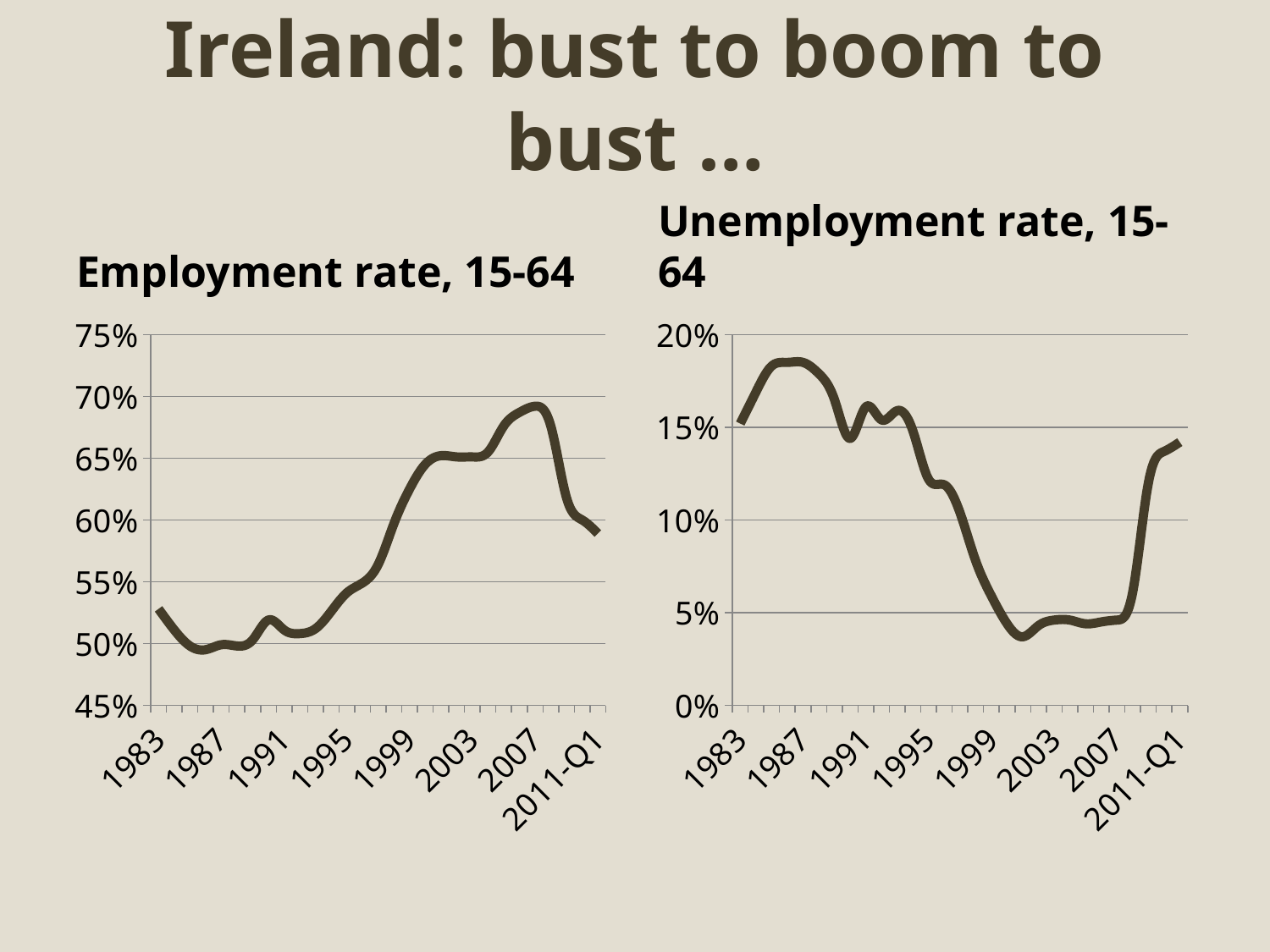
In the 'Employment rate, 15-64' chart, does the employment rate rise or fall between 1991 and 2007? rise In the 'Unemployment rate, 15-64' chart, is the value for 1987 greater or less than 15%? greater What kind of chart is the 'Unemployment rate, 15-64' chart? line chart How many charts are shown on the slide? 2 In the 'Employment rate, 15-64' chart, is the value for 2007 greater or less than 65%? greater In the 'Unemployment rate, 15-64' chart, is the value for 2011-Q1 greater or less than 10%? greater What kind of chart is the 'Employment rate, 15-64' chart? line chart What is the title of the chart on the right of the slide? Unemployment rate, 15-64 In the 'Unemployment rate, 15-64' chart, does the unemployment rate rise or fall between 1987 and 2001? fall